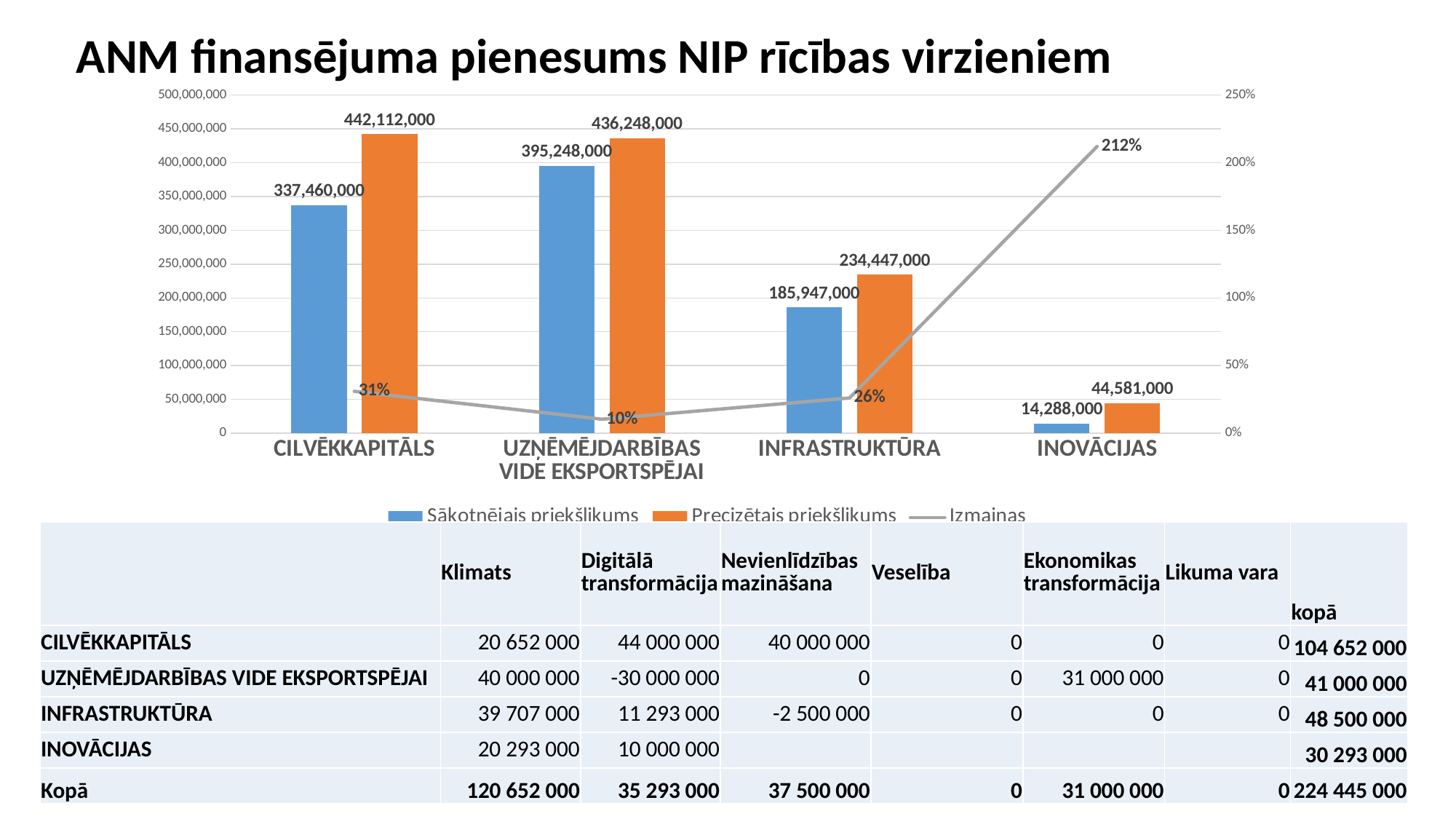
What is the value of Sākotnējais priekšlikums for INOVĀCIJAS? 14,288,000 What is the value of Sākotnējais priekšlikums for CILVĒKKAPITĀLS? 337,460,000 What is the difference between Precizētais priekšlikums and Sākotnējais priekšlikums for INFRASTRUKTŪRA? 48,500,000 What is the Izmaiņas percentage for INOVĀCIJAS? 212% Which category has the highest Precizētais priekšlikums value? CILVĒKKAPITĀLS Which category has the lowest Izmaiņas percentage? UZŅĒMĒJDARBĪBAS VIDE EKSPORTSPĒJAI What is the value of Precizētais priekšlikums for INFRASTRUKTŪRA? 234,447,000 What kind of chart is shown on the slide? Combination bar and line chart How many categories are shown on the x axis of the chart? 4 How many series does the chart legend list? 3 What is the difference between Precizētais priekšlikums and Sākotnējais priekšlikums for CILVĒKKAPITĀLS? 104,652,000 Which is larger: Sākotnējais priekšlikums for UZŅĒMĒJDARBĪBAS VIDE EKSPORTSPĒJAI or Sākotnējais priekšlikums for CILVĒKKAPITĀLS? UZŅĒMĒJDARBĪBAS VIDE EKSPORTSPĒJAI